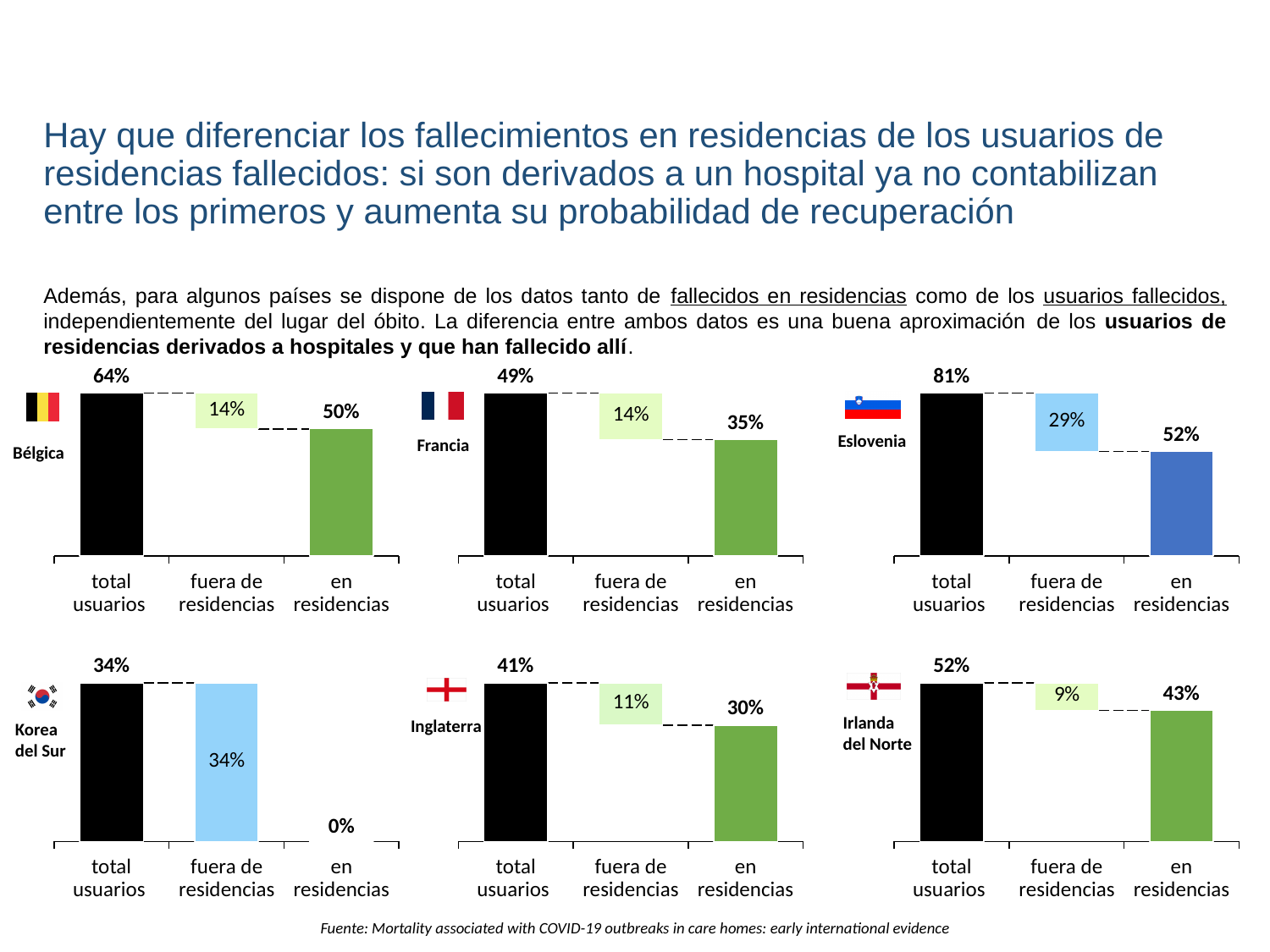
In the Eslovenia chart, what is the value for fuera de residencias? 29% In the Korea del Sur chart, what is the value for en residencias? 0% What kind of chart is used for Korea del Sur? bar chart In the Francia chart, what is the value for en residencias? 35% In the Francia chart, which is larger: total usuarios or en residencias? total usuarios In the Bélgica chart, what is the difference between total usuarios and en residencias? 14% In the Irlanda del Norte chart, which category has the lowest value? fuera de residencias In the Bélgica chart, what is the value for total usuarios? 64% In the Eslovenia chart, which category has the highest value? total usuarios In the Inglaterra chart, what is the value for total usuarios? 41% In the Irlanda del Norte chart, what is the value for fuera de residencias? 9% How many categories are shown on the x axis of the Inglaterra chart? 3